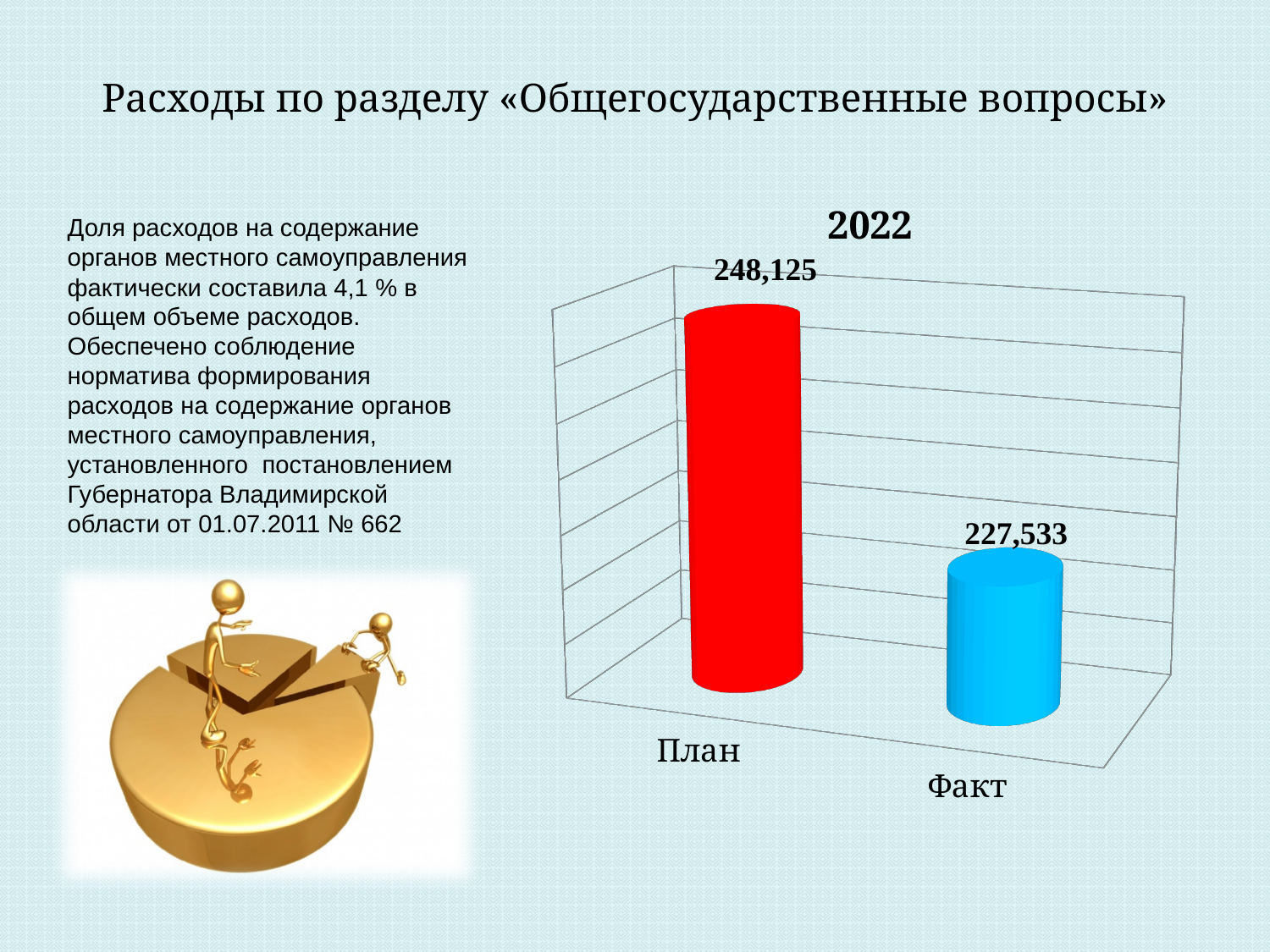
What is the title of the chart? 2022 Which category has the highest value in the chart? План How many categories are shown in the chart? 2 What is the value for Факт in the 2022 chart? 227,533 What colour is the bar for Факт? Blue Which is larger, the value for План or the value for Факт? План What kind of chart is shown on the slide? Bar chart Which category has the lowest value in the chart? Факт What is the value for План in the 2022 chart? 248,125 What is the difference between the План and Факт values? 20,592